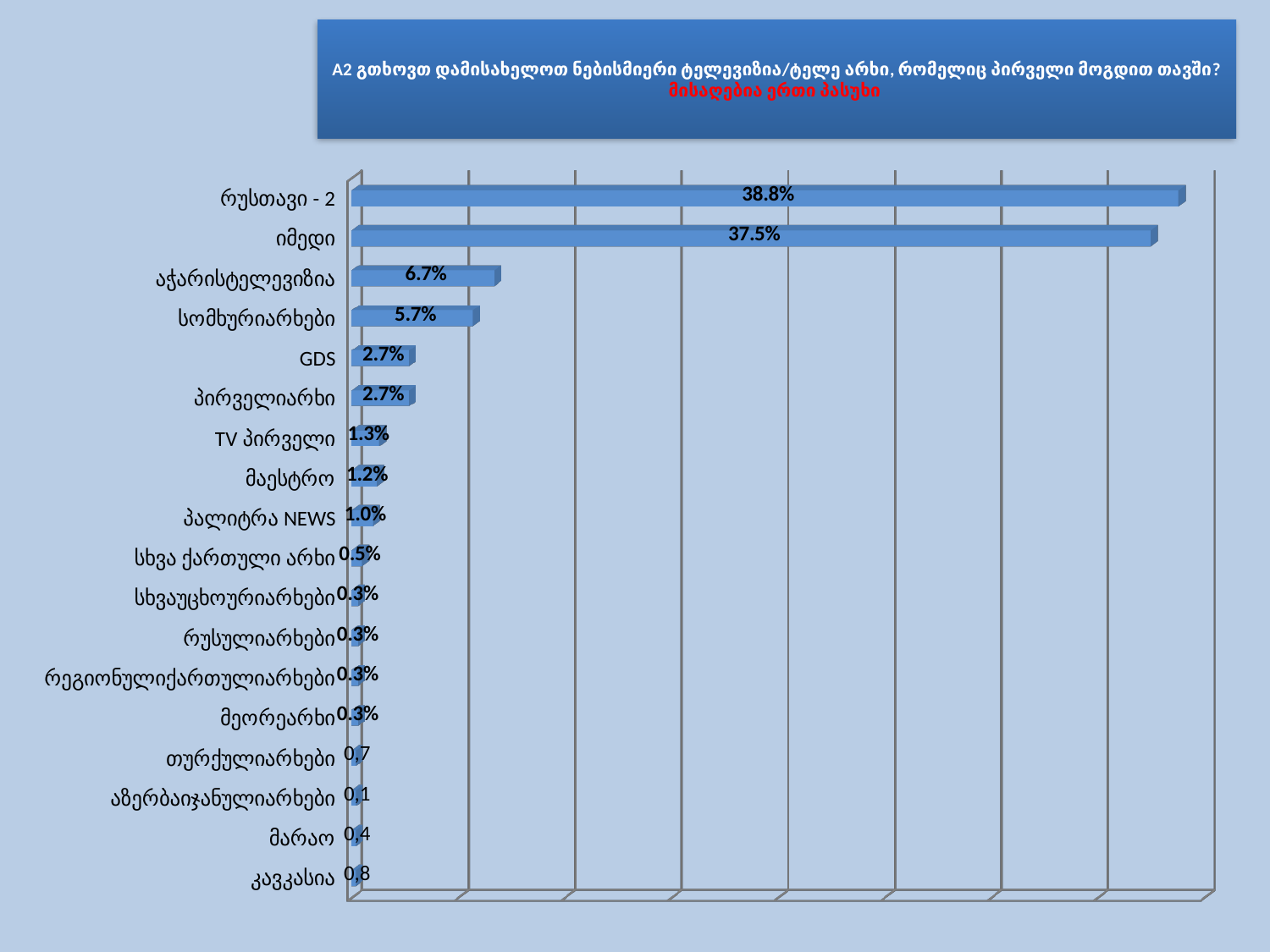
Which category has the highest value? რუსთავი - 2 What is the value for იმედი? 37.5% What kind of chart is shown on the slide? bar chart What is the difference between the values for რუსთავი - 2 and იმედი? 1.3% Which has a larger value, TV პირველი or პალიტრა NEWS? TV პირველი What is the difference between the values for აჭარისტელევიზია and სომხურიარხები? 1.0% What is the value for სომხურიარხები? 5.7% What is the value for GDS? 2.7% What is the value for მაესტრო? 1.2% What is the value for აჭარისტელევიზია? 6.7% How many categories are shown in the chart? 18 What is the value for რუსთავი - 2? 38.8%